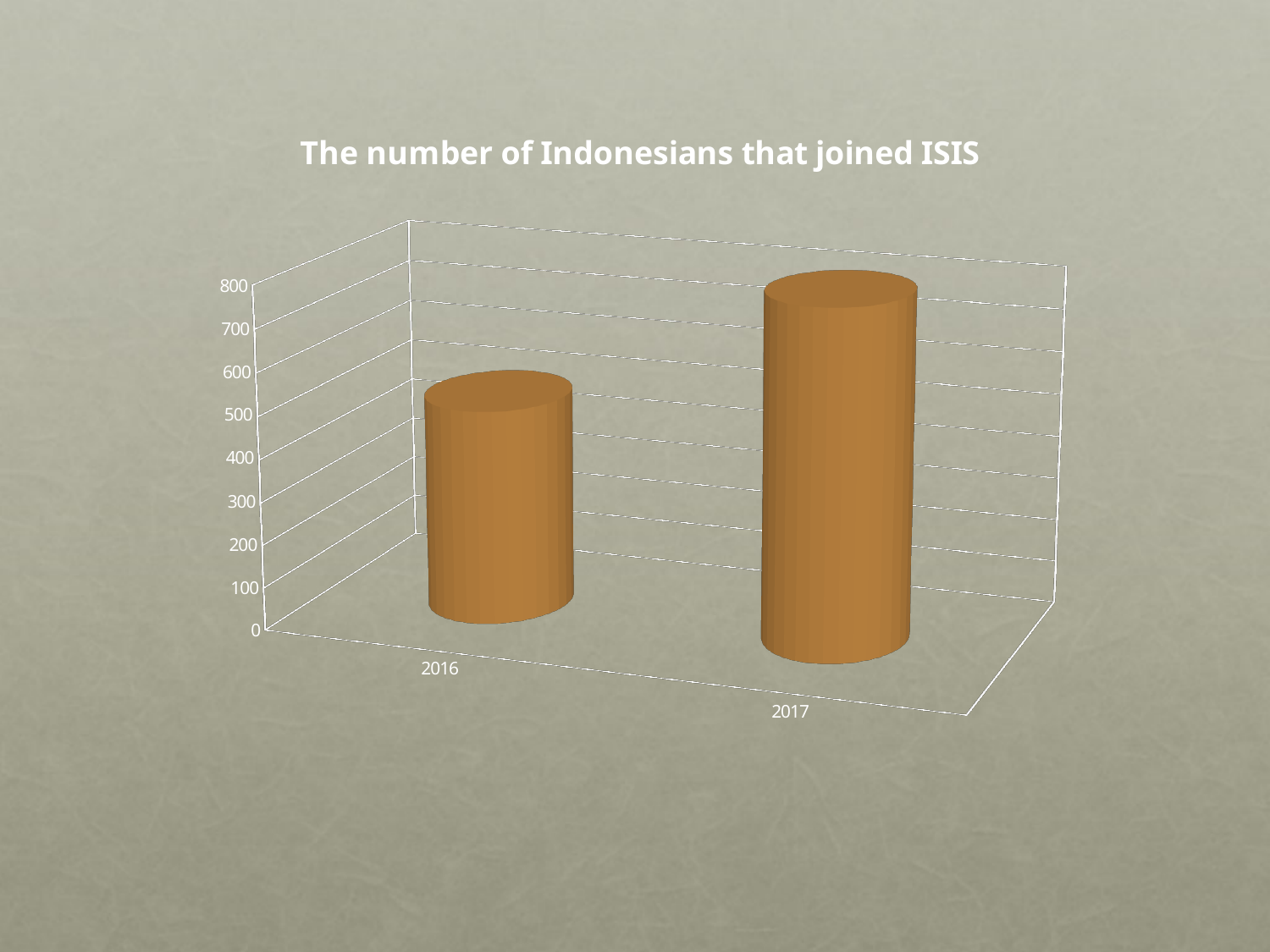
Is the value for 2016 greater or less than 700? less Which year has the highest value? 2017 Is the value for 2017 greater or less than 400? greater Do the values rise or fall from 2016 to 2017? rise What is the title of the chart? The number of Indonesians that joined ISIS Which year has the lowest value? 2016 Which is larger, the value for 2016 or the value for 2017? 2017 Is the value for 2016 greater or less than 200? greater What kind of chart is shown on the slide? bar chart How many categories are plotted on the x axis? 2 What is the highest value shown on the vertical axis? 800